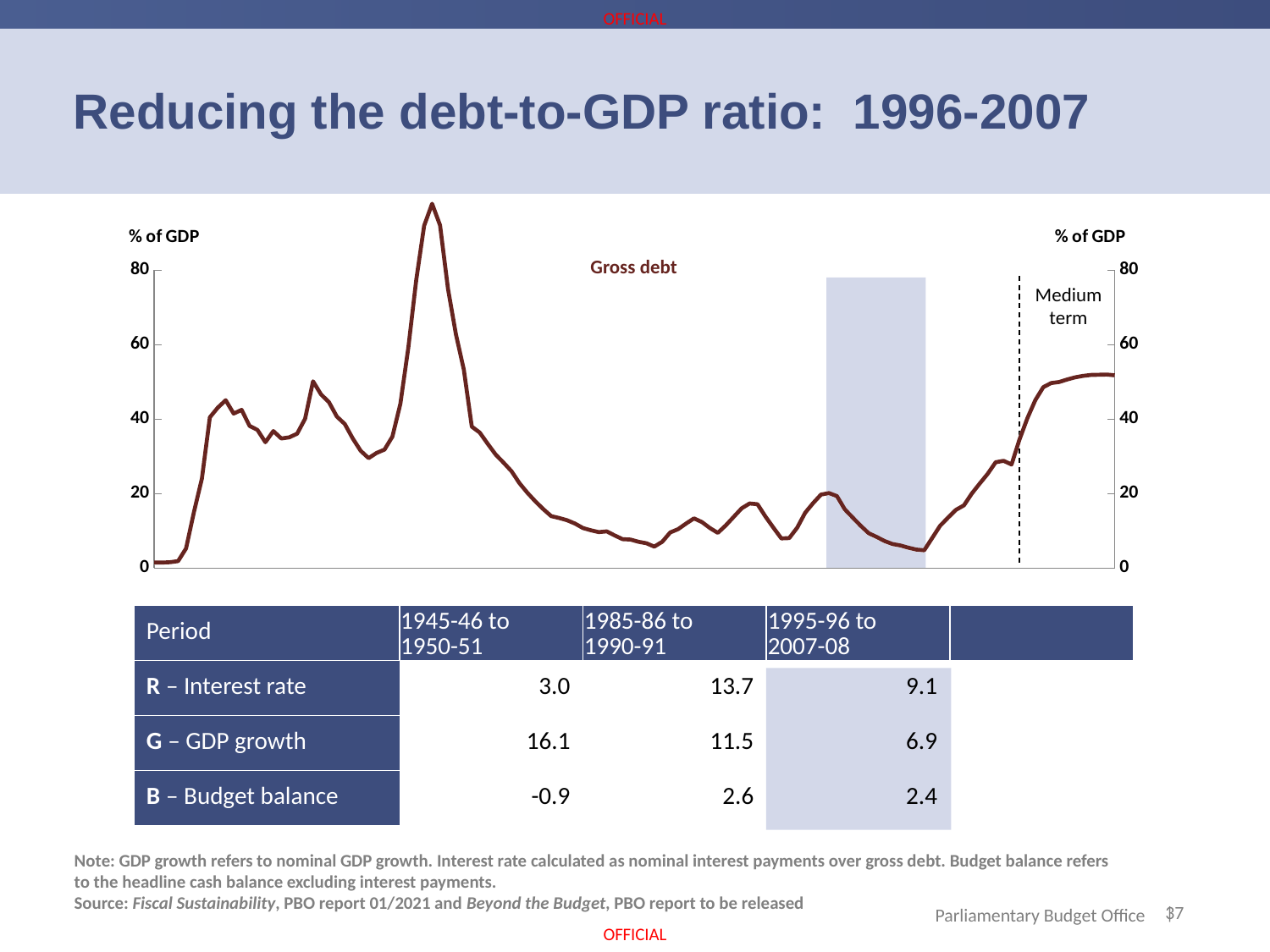
What series is plotted in the line chart? Gross debt Is the peak value of gross debt in the chart greater or less than 60% of GDP? greater Does gross debt rise or fall across the shaded region of the chart? fall What unit is shown on the vertical axes of the chart? % of GDP Is the gross debt value at the far left of the chart greater or less than 20% of GDP? less Within the shaded region of the chart, is gross debt greater or less than 40% of GDP? less Which of the two peaks is higher in the chart: the tallest peak near the left-centre or the value at the right-hand end? the tallest peak near the left-centre What kind of chart is shown on the slide? line chart Does gross debt rise or fall after the dashed vertical line in the chart? rise What is the highest value labelled on the left vertical axis of the chart? 80